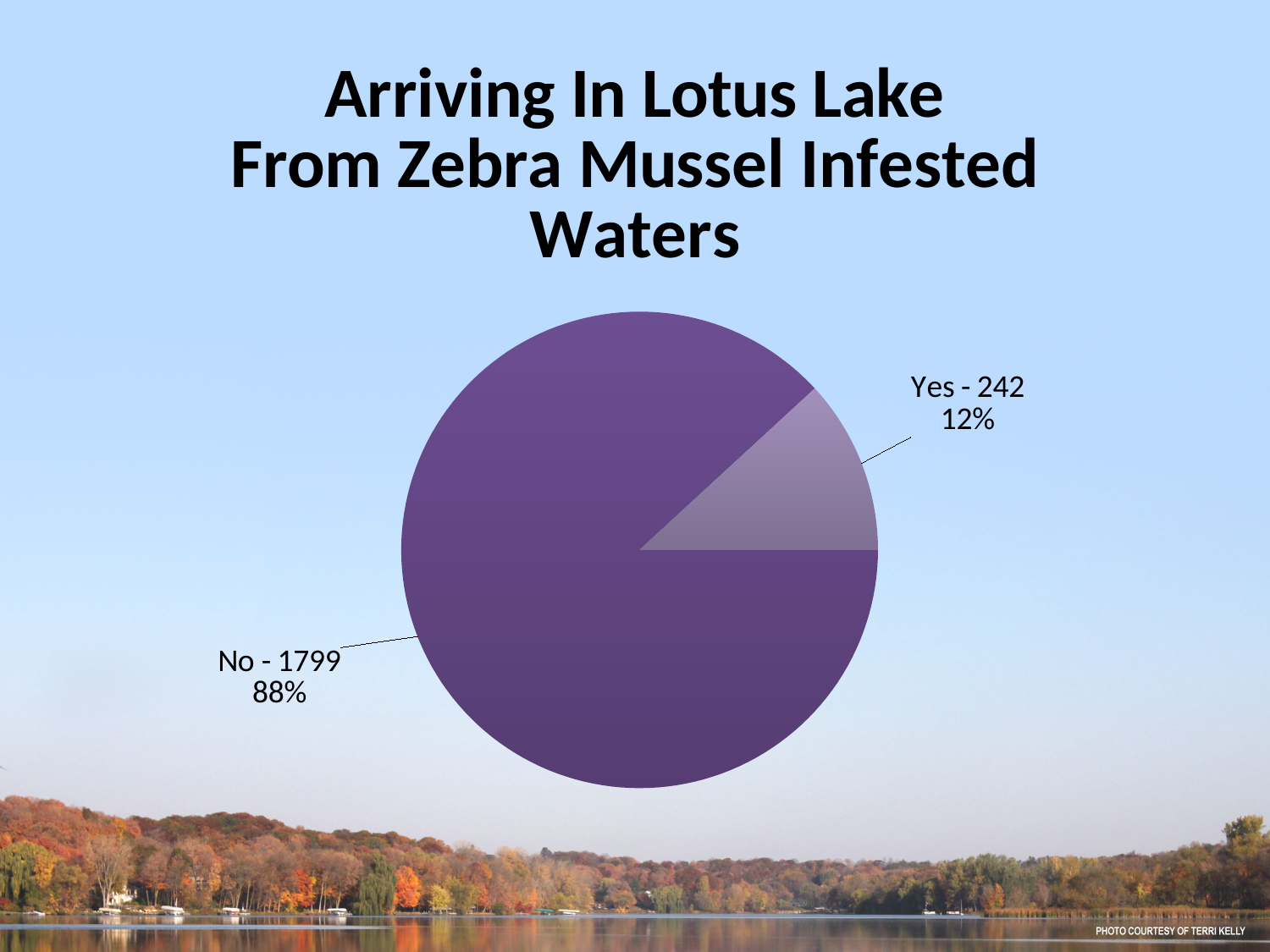
What is the value for the "Yes" slice? 242 What is the difference between the "No" and "Yes" values? 1557 Which is larger, the "Yes" slice or the "No" slice? No What share of the pie does the "No" slice represent? 88% What is the total of the two slices? 2041 How many slices does the pie chart have? 2 What is the value for the "No" slice? 1799 Which slice is the smallest? Yes What kind of chart is shown on the slide? pie chart Which slice is the largest? No What share of the pie does the "Yes" slice represent? 12% What is the title of the chart? Arriving In Lotus Lake From Zebra Mussel Infested Waters